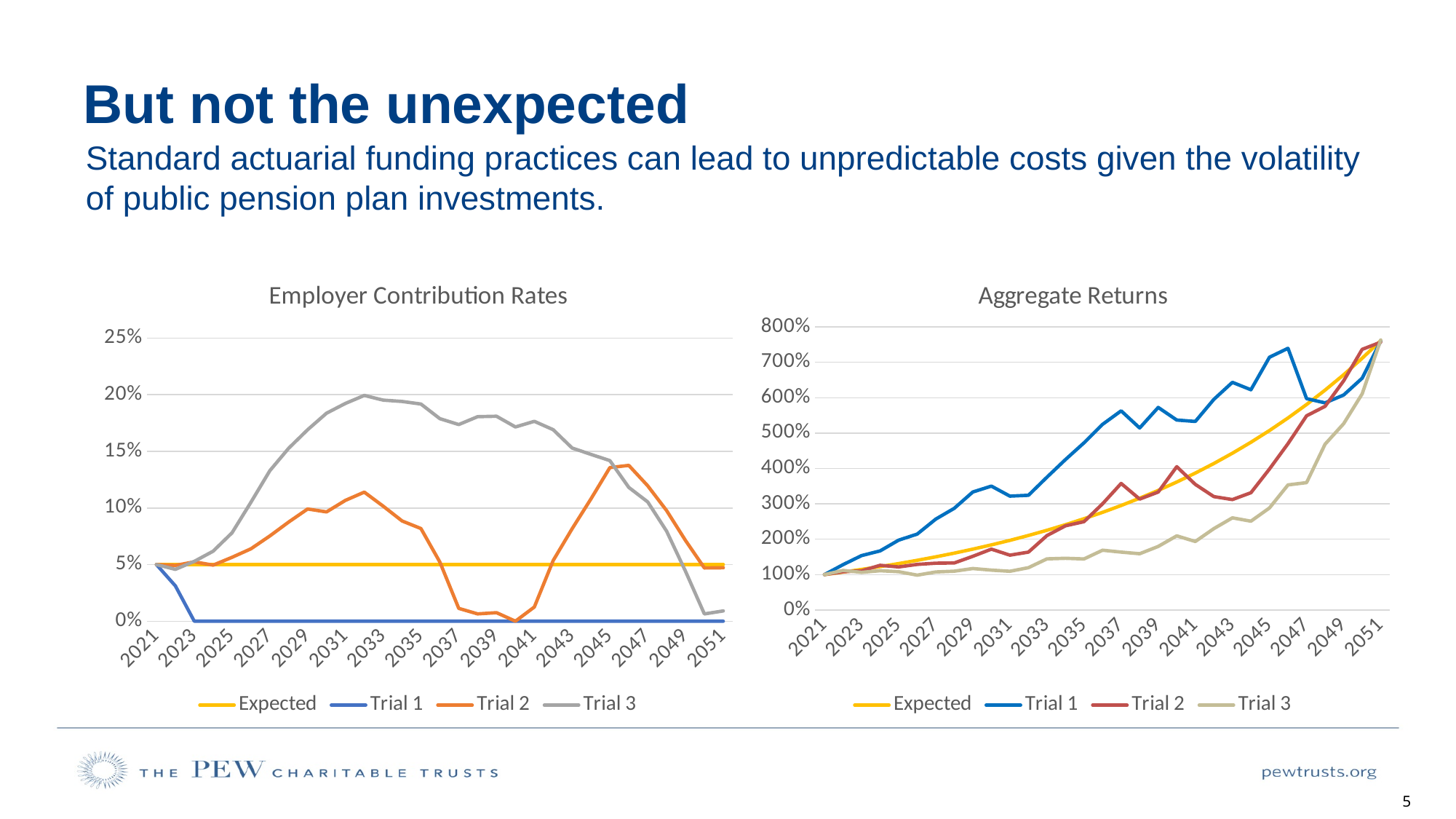
In the Employer Contribution Rates chart, what is the value of the Expected series in 2041? 5% What kind of chart is the Employer Contribution Rates chart? line chart In the Employer Contribution Rates chart, is the value for Trial 2 in 2037 greater or less than 5%? less In the Employer Contribution Rates chart, is the value for Trial 3 in 2031 greater or less than 15%? greater In the Aggregate Returns chart, is the value for Trial 3 in 2041 greater or less than 300%? less In the Employer Contribution Rates chart, what is the value of Trial 1 in 2035? 0% In the Aggregate Returns chart, which series has the highest value in 2037? Trial 1 In the Aggregate Returns chart, what is the value of Trial 1 in 2021? 100% In the Aggregate Returns chart, does the Expected series rise or fall from 2021 to 2051? rise How many series does the legend of the Aggregate Returns chart list? 4 In the Employer Contribution Rates chart, which series has the higher value in 2031, Trial 2 or Trial 3? Trial 3